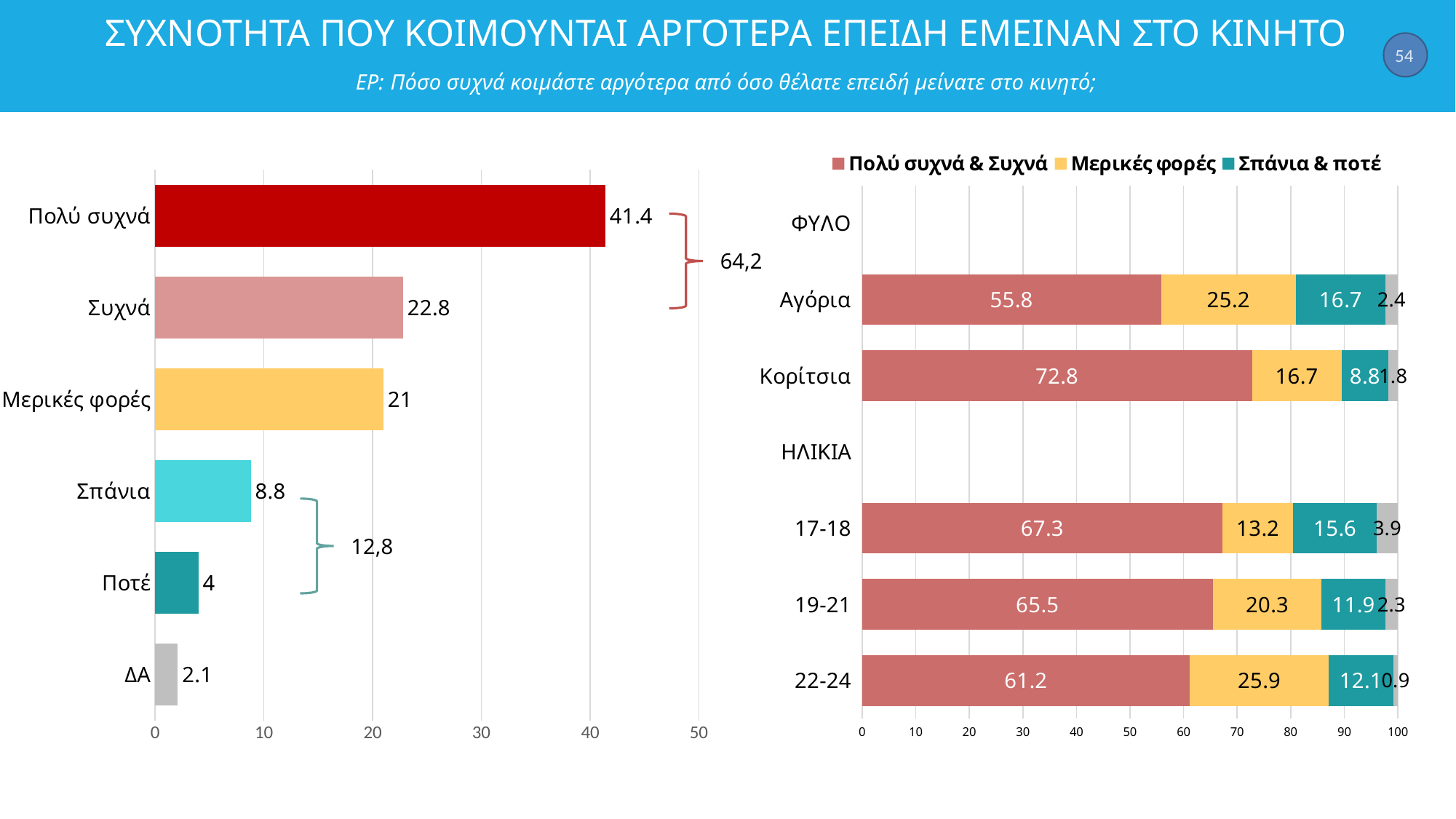
In the left chart, what is the value for Σπάνια? 8.8 In the left chart, how many categories are shown? 6 In the left chart, which category has the lowest value? ΔΑ In the right chart, what is the value of Πολύ συχνά & Συχνά for Κορίτσια? 72.8 In the left chart, which category has the highest value? Πολύ συχνά In the left chart, what is the value for Πολύ συχνά? 41.4 In the right chart, which age group has the highest value for Πολύ συχνά & Συχνά? 17-18 In the left chart, what is the difference between the values for Συχνά and Μερικές φορές? 1.8 In the right chart, what is the value of Μερικές φορές for 22-24? 25.9 In the right chart, how many series does the legend list? 3 In the right chart, which is larger for Σπάνια & ποτέ: Αγόρια or Κορίτσια? Αγόρια What kind of chart is the left chart? Bar chart